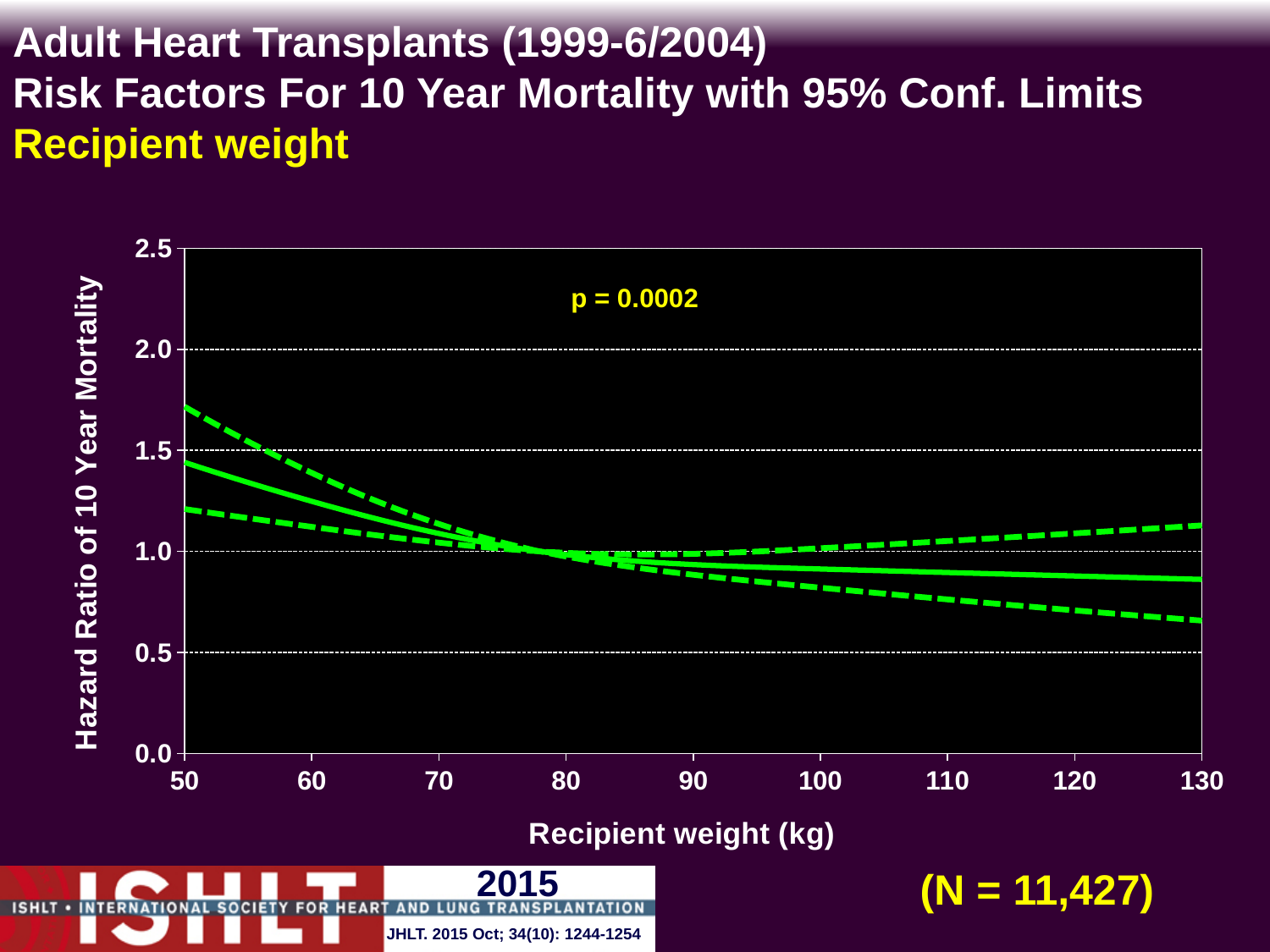
Is the upper 95% confidence limit at a recipient weight of 50 kg greater or less than 1.5? greater How many lines are plotted on the chart? 3 What p-value is shown on the chart? p = 0.0002 Does the hazard ratio of 10 year mortality rise or fall as recipient weight increases from 50 kg to 130 kg? fall Is the lower 95% confidence limit at a recipient weight of 130 kg greater or less than 0.5? greater Is the hazard ratio (solid line) at a recipient weight of 50 kg greater or less than 1.0? greater What is the sample size (N) shown on the slide? N = 11,427 What kind of chart is shown on the slide? line chart What is the label of the x axis? Recipient weight (kg) Is the hazard ratio at a recipient weight of 50 kg larger or smaller than at 130 kg? larger